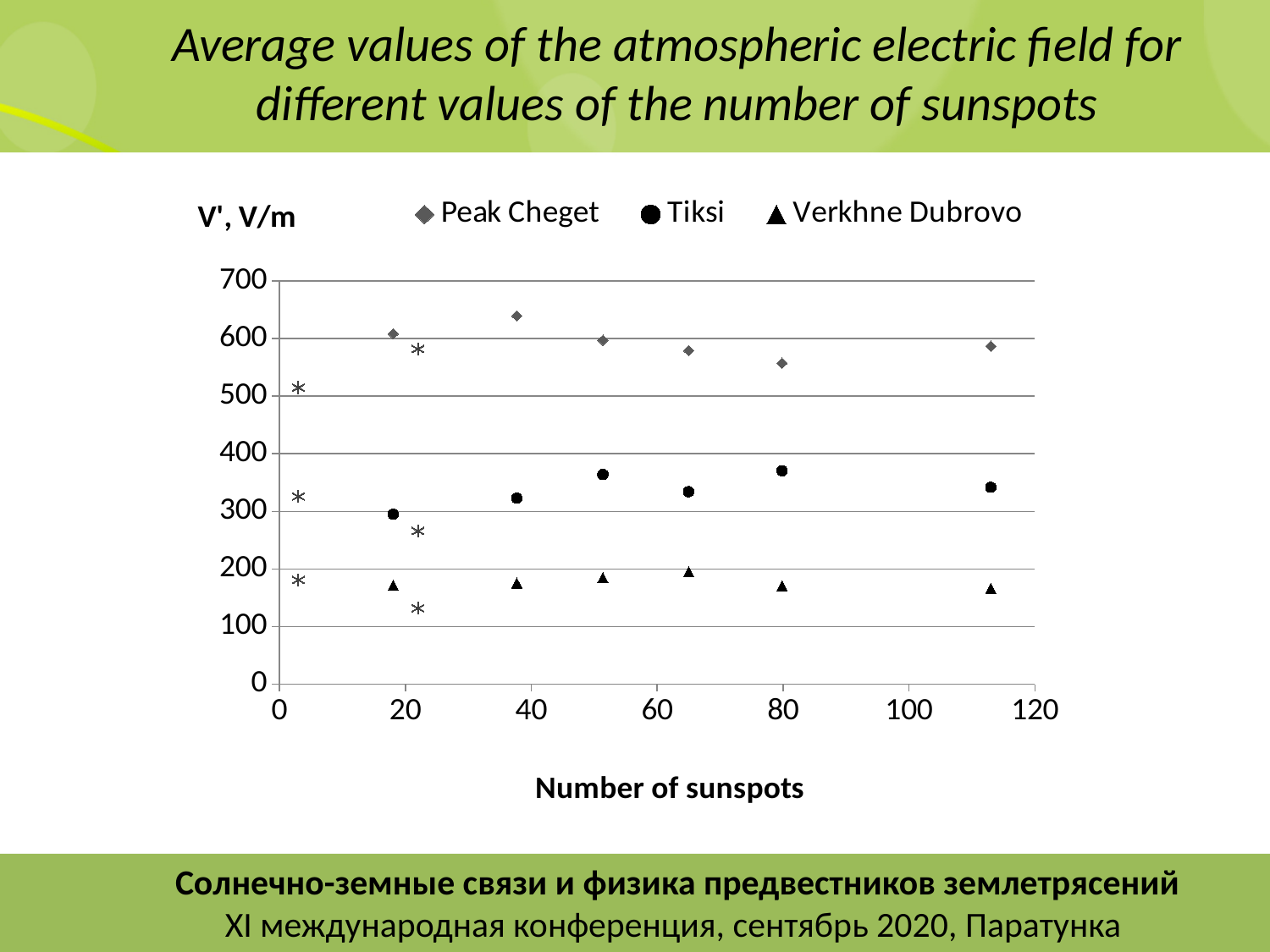
What is the label of the horizontal axis? Number of sunspots Is the Verkhne Dubrovo value at about 113 sunspots greater or less than 200? less At about 113 sunspots, which is larger: the Peak Cheget value or the Tiksi value? Peak Cheget Is the Peak Cheget value at about 80 sunspots greater or less than 600? less How many series does the legend list? 3 Which series has the highest values overall? Peak Cheget Is the Tiksi value at about 80 sunspots greater or less than 400? less What kind of chart is shown on the slide? Scatter chart Which series are listed in the legend? Peak Cheget, Tiksi, Verkhne Dubrovo How many Tiksi data points are plotted? 6 Which series has the lowest values overall? Verkhne Dubrovo